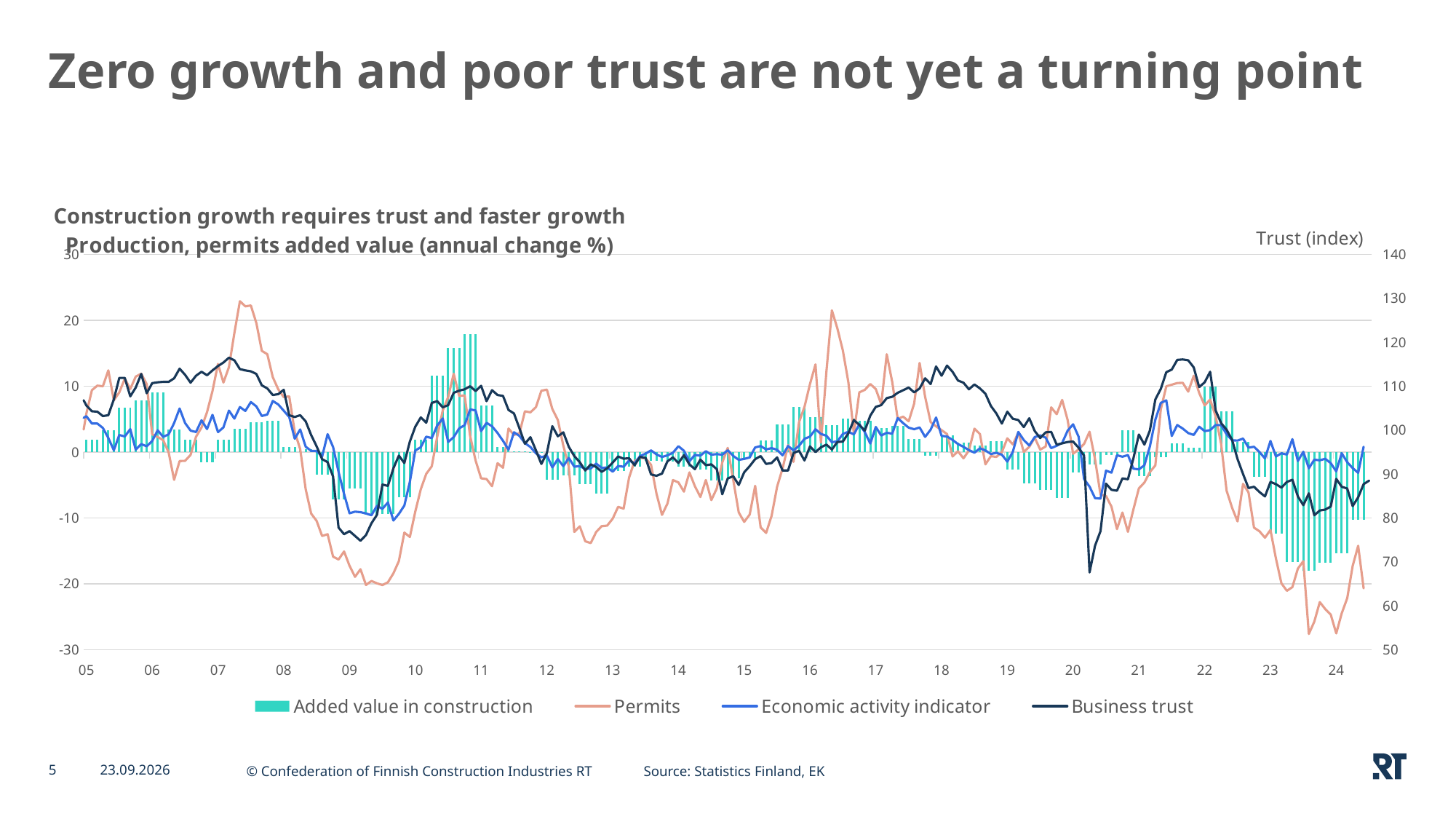
What is the label of the right-hand vertical axis? Trust (index) Which dip in Business trust is lower: the one around 2009 or the one around 2020? 2020 How many series does the legend list? 4 Is the Business trust value at its 2020 dip greater or less than 80 on the right axis? less Does the Permits line generally rise or fall from 2022 to 2024? fall Are the Added value in construction bars around 2023 greater or less than -10? less Is the peak of Business trust around 2007 greater or less than 110 on the right axis? greater How many year labels are shown along the x axis? 20 Which series is plotted as bars rather than a line? Added value in construction What kind of chart is shown on the slide? A combined bar and line chart